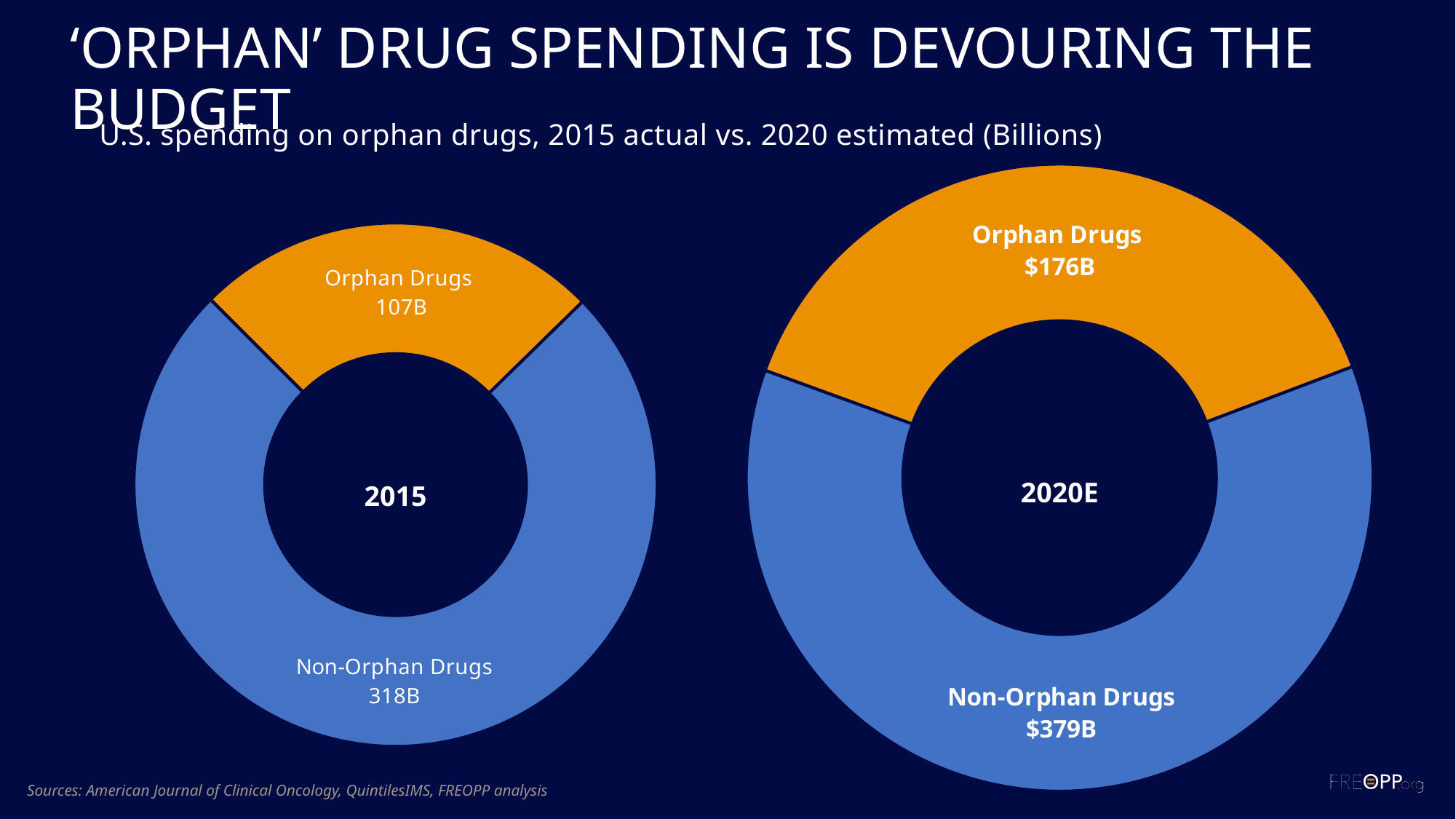
In the 2020E chart, what is the difference between Non-Orphan Drugs and Orphan Drugs? $203B In the 2015 chart, what is the value for Orphan Drugs? 107B In the 2015 chart, what is the value for Non-Orphan Drugs? 318B What kind of chart is the 2015 chart? Donut chart In the 2020E chart, what is the value for Non-Orphan Drugs? $379B In the 2015 chart, what is the difference between Non-Orphan Drugs and Orphan Drugs? 211B What is the total spending shown in the 2020E chart? $555B In the 2015 chart, which category has the smallest value? Orphan Drugs How many categories does the 2020E chart show? 2 Is Orphan Drugs spending larger in the 2015 chart or the 2020E chart? 2020E In the 2020E chart, which category has the largest value? Non-Orphan Drugs In the 2020E chart, what is the value for Orphan Drugs? $176B